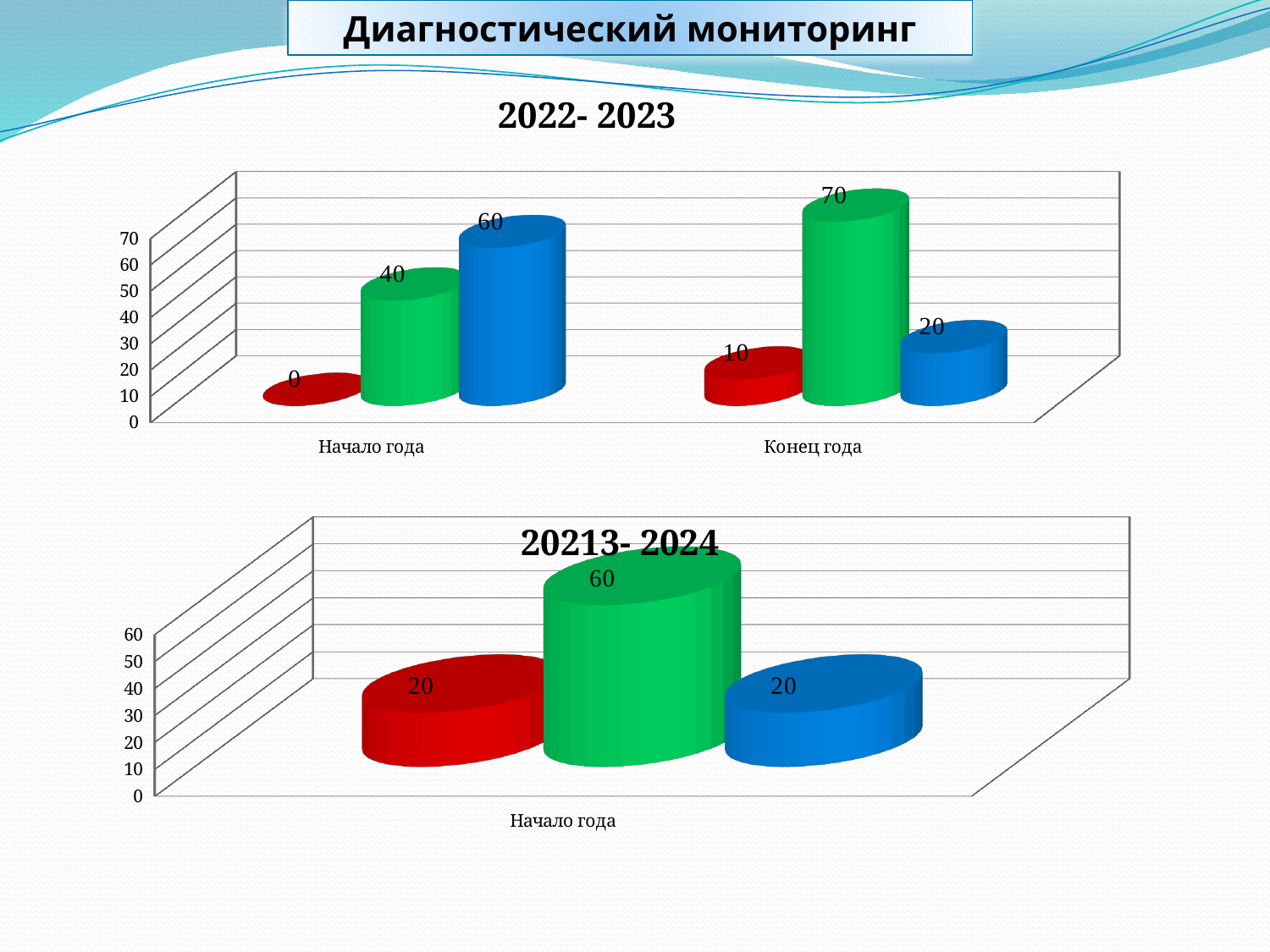
In the chart titled "2022- 2023", which bar has the highest value across both categories? The green bar for Конец года (70) In the chart titled "2022- 2023", what is the value of the red bar for "Конец года"? 10 In the chart titled "2022- 2023", what is the value of the red bar for "Начало года"? 0 In the chart titled "2022- 2023", what is the value of the green bar for "Начало года"? 40 In the chart titled "20213- 2024", what is the difference between the green bar and the red bar? 40 In the chart titled "20213- 2024", what is the value of the green bar? 60 In the chart titled "2022- 2023", what is the value of the blue bar for "Конец года"? 20 In the chart titled "20213- 2024", which bar has the lowest value? The red and blue bars (both 20) In the chart titled "2022- 2023", how many categories are shown on the x axis? 2 In the chart titled "2022- 2023", which is larger: the blue bar for "Начало года" or the blue bar for "Конец года"? Начало года What type of chart is the bottom chart titled "20213- 2024"? Bar chart In the chart titled "2022- 2023", what is the difference between the green bar values for "Конец года" and "Начало года"? 30